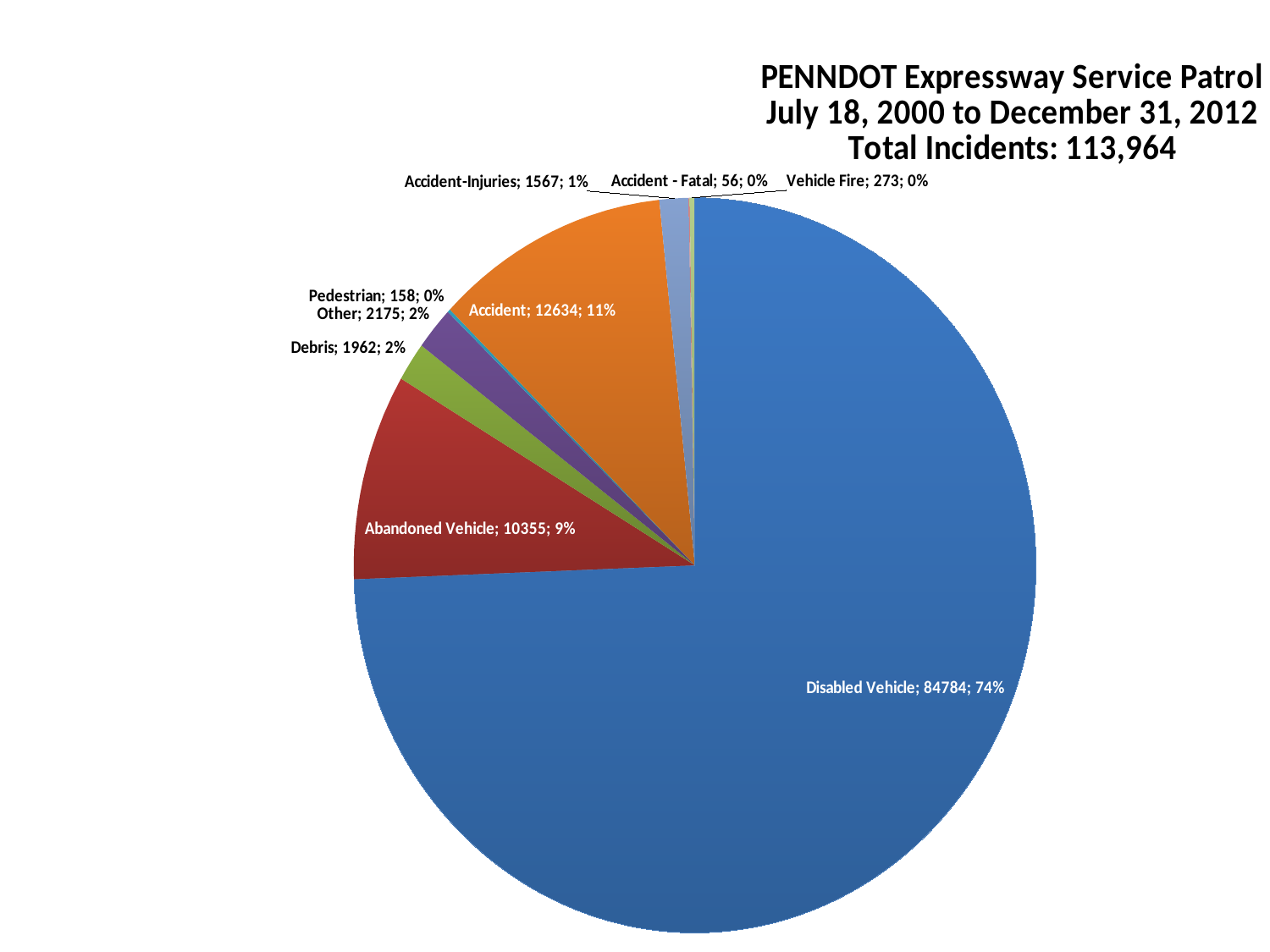
What is the difference in incidents between Accident and Abandoned Vehicle? 2279 What total number of incidents is stated in the chart title? 113,964 What share of the pie does Disabled Vehicle represent? 74% How many categories are shown in the pie chart? 9 Which has more incidents, Other or Debris? Other How many incidents are labelled for Accident? 12634 Which category has the smallest number of incidents? Accident - Fatal What share of the pie does Abandoned Vehicle represent? 9% How many incidents are labelled for Disabled Vehicle? 84784 What kind of chart is shown on the slide? Pie chart What date range does the chart title cover? July 18, 2000 to December 31, 2012 Which category has the largest slice of the pie? Disabled Vehicle